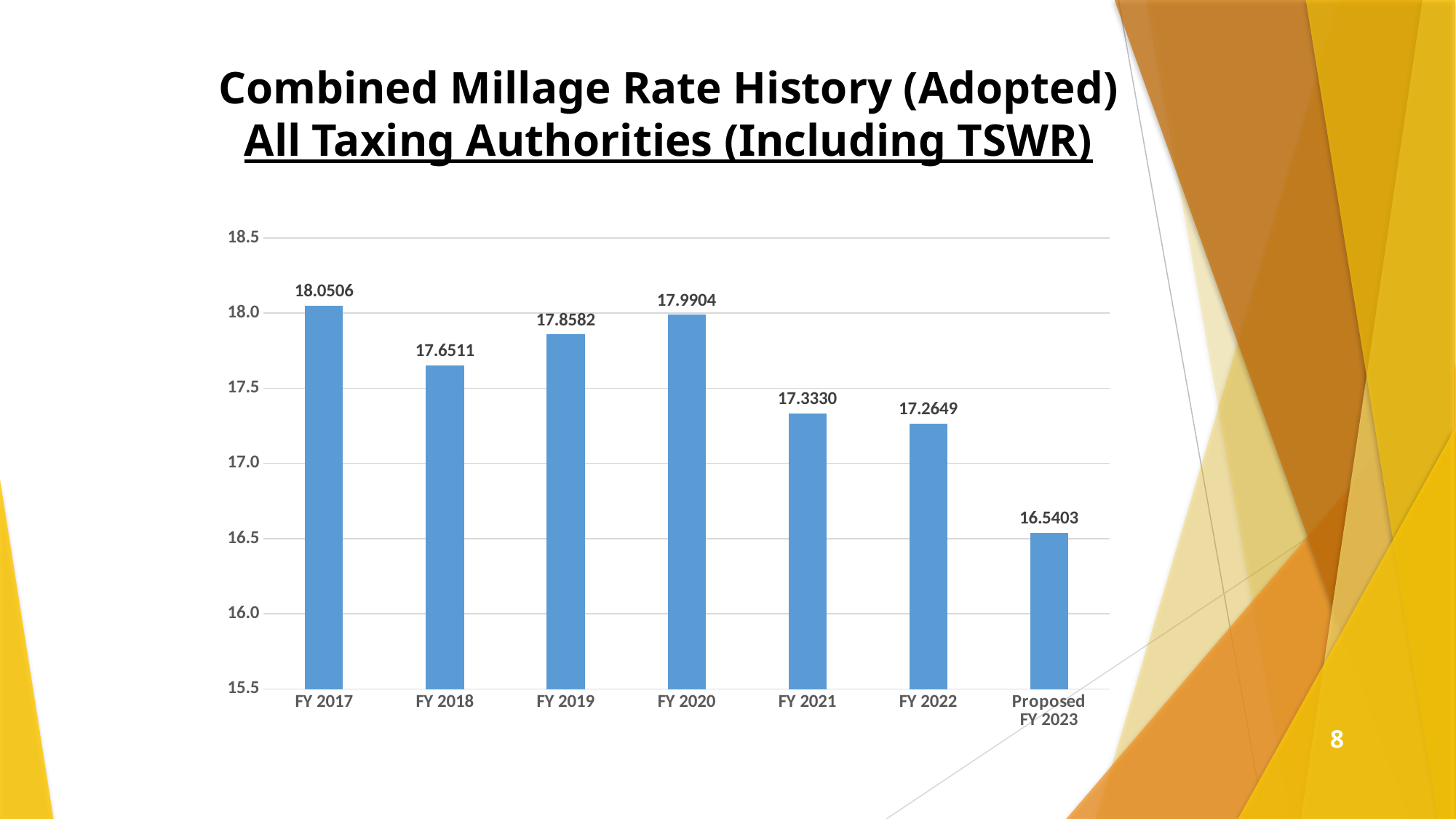
What kind of chart is shown on the slide? Bar chart What is the difference between the FY 2020 value and the FY 2021 value? 0.6574 Which is larger, the value for FY 2018 or the value for FY 2019? FY 2019 How many fiscal years are shown on the chart? 7 What is the combined millage rate shown for FY 2017? 18.0506 Is the value for FY 2021 greater or less than 17.5? less Which fiscal year has the highest millage rate on the chart? FY 2017 Which category has the lowest millage rate on the chart? Proposed FY 2023 What is the value shown for FY 2020? 17.9904 What is the difference between the FY 2017 value and the Proposed FY 2023 value? 1.5103 What is the value shown for Proposed FY 2023? 16.5403 Do the values rise or fall from FY 2020 to Proposed FY 2023? Fall